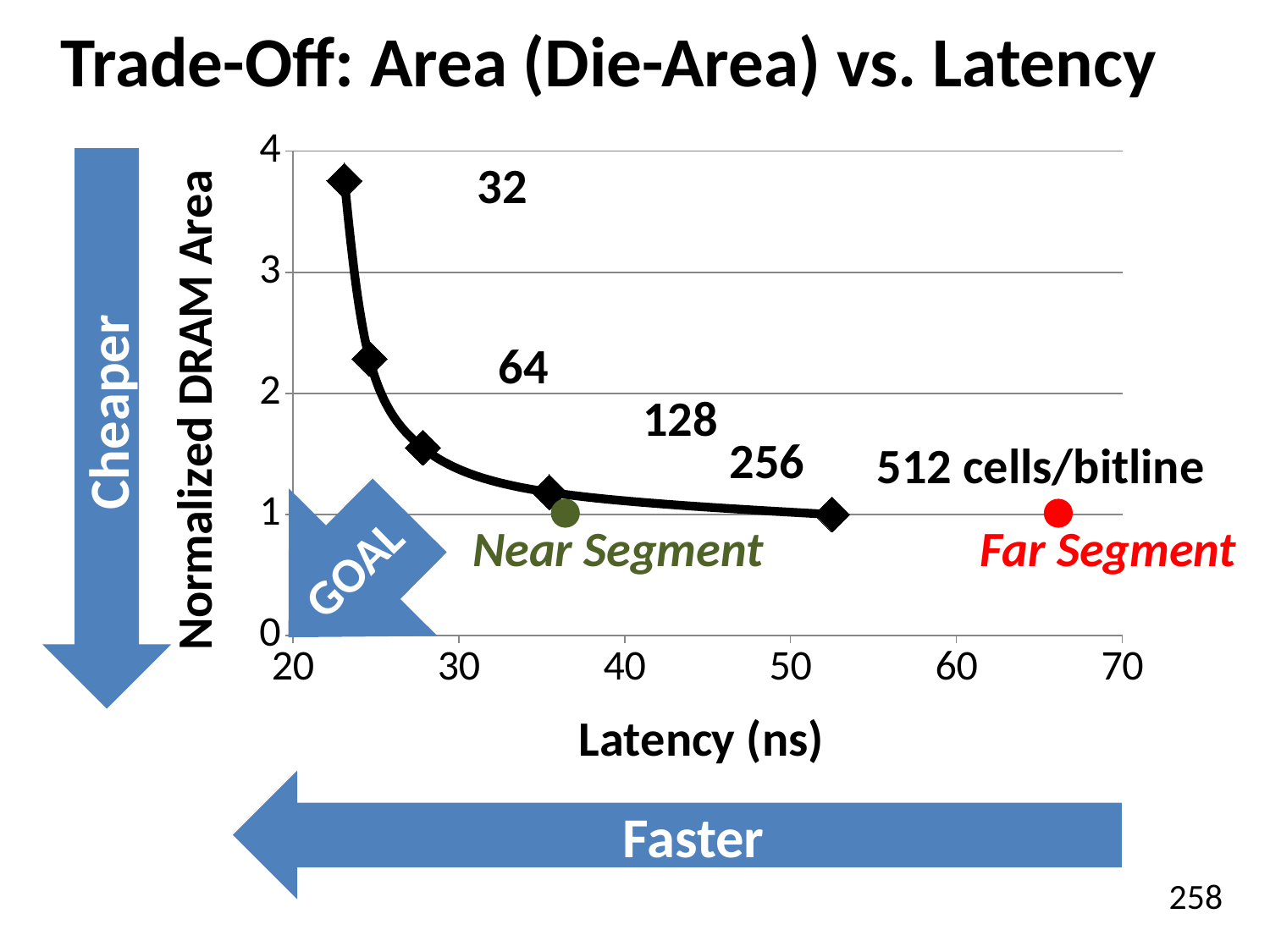
How many diamond-marked data points are plotted on the black curve? 5 What is the label of the x axis? Latency (ns) Which cells/bitline configuration has the lowest normalized DRAM area? 512 Is the normalized DRAM area for 32 cells/bitline greater or less than 3? greater As latency increases along the x axis, does the normalized DRAM area rise or fall? fall Which has a higher normalized DRAM area, 32 cells/bitline or 256 cells/bitline? 32 cells/bitline What is the title of the chart on the slide? Trade-Off: Area (Die-Area) vs. Latency Is the normalized DRAM area for 64 cells/bitline greater or less than 2? greater Is the normalized DRAM area for 128 cells/bitline greater or less than 2? less Which cells/bitline configuration has the highest normalized DRAM area? 32